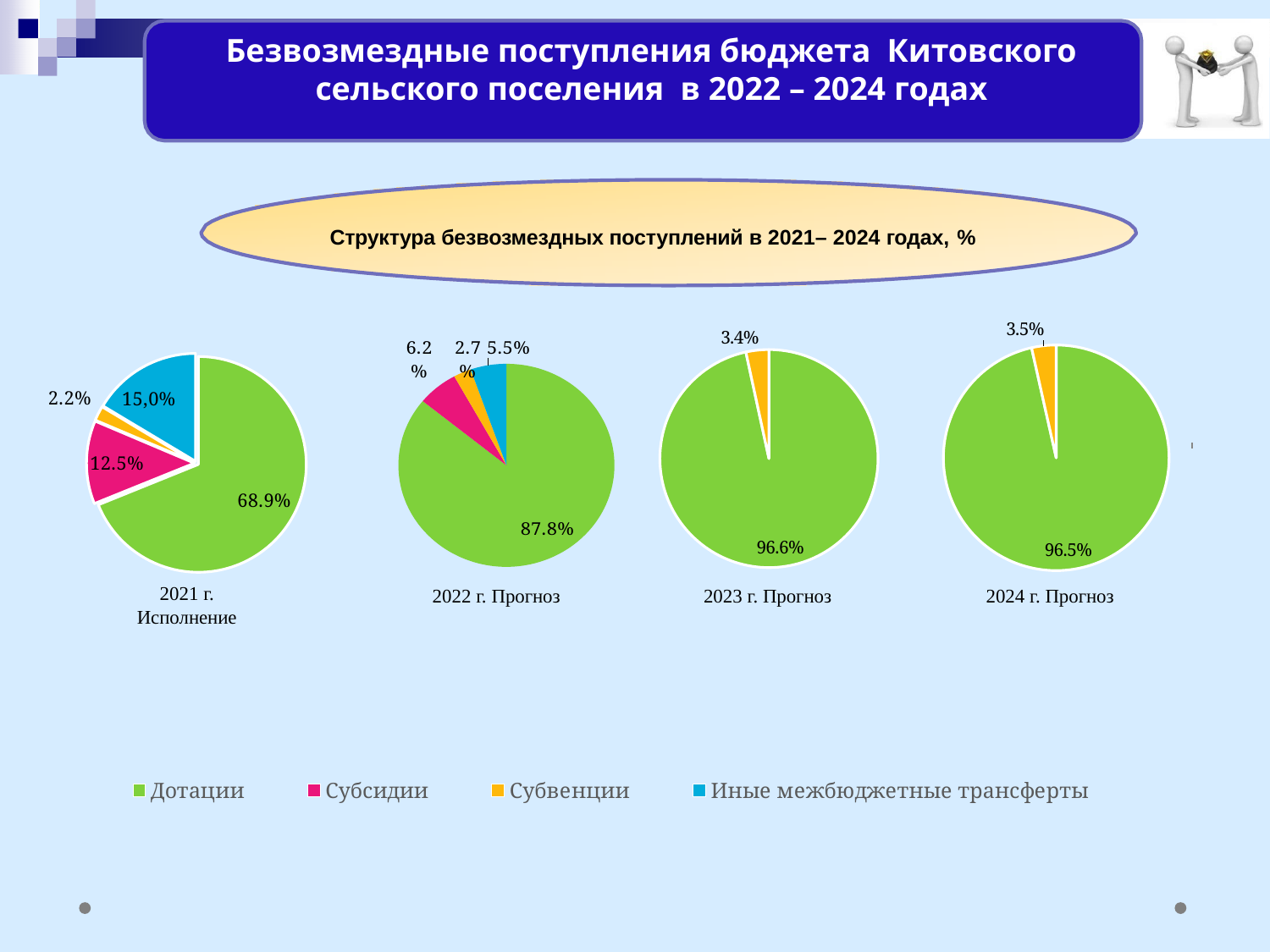
In the 2024 г. Прогноз pie chart, what is the share of Дотации? 96.5% What is the difference between the Дотации share in the 2022 г. Прогноз chart and in the 2021 г. Исполнение chart? 18.9 percentage points In the 2022 г. Прогноз pie chart, which category has the largest share? Дотации In the 2021 г. Исполнение pie chart, what is the share of Иные межбюджетные трансферты? 15,0% In the 2022 г. Прогноз pie chart, what is the share of Субсидии? 6.2% What type of chart is used to show the structure of receipts for each year? Pie chart How many pie charts are shown on the slide? 4 In the 2021 г. Исполнение pie chart, which category has the smallest share? Субвенции In the 2021 г. Исполнение pie chart, what is the share of Дотации? 68.9% In the 2021 г. Исполнение pie chart, which is larger: Субсидии or Иные межбюджетные трансферты? Иные межбюджетные трансферты How many entries does the legend list? 4 In the 2023 г. Прогноз pie chart, what is the share of Субвенции? 3.4%